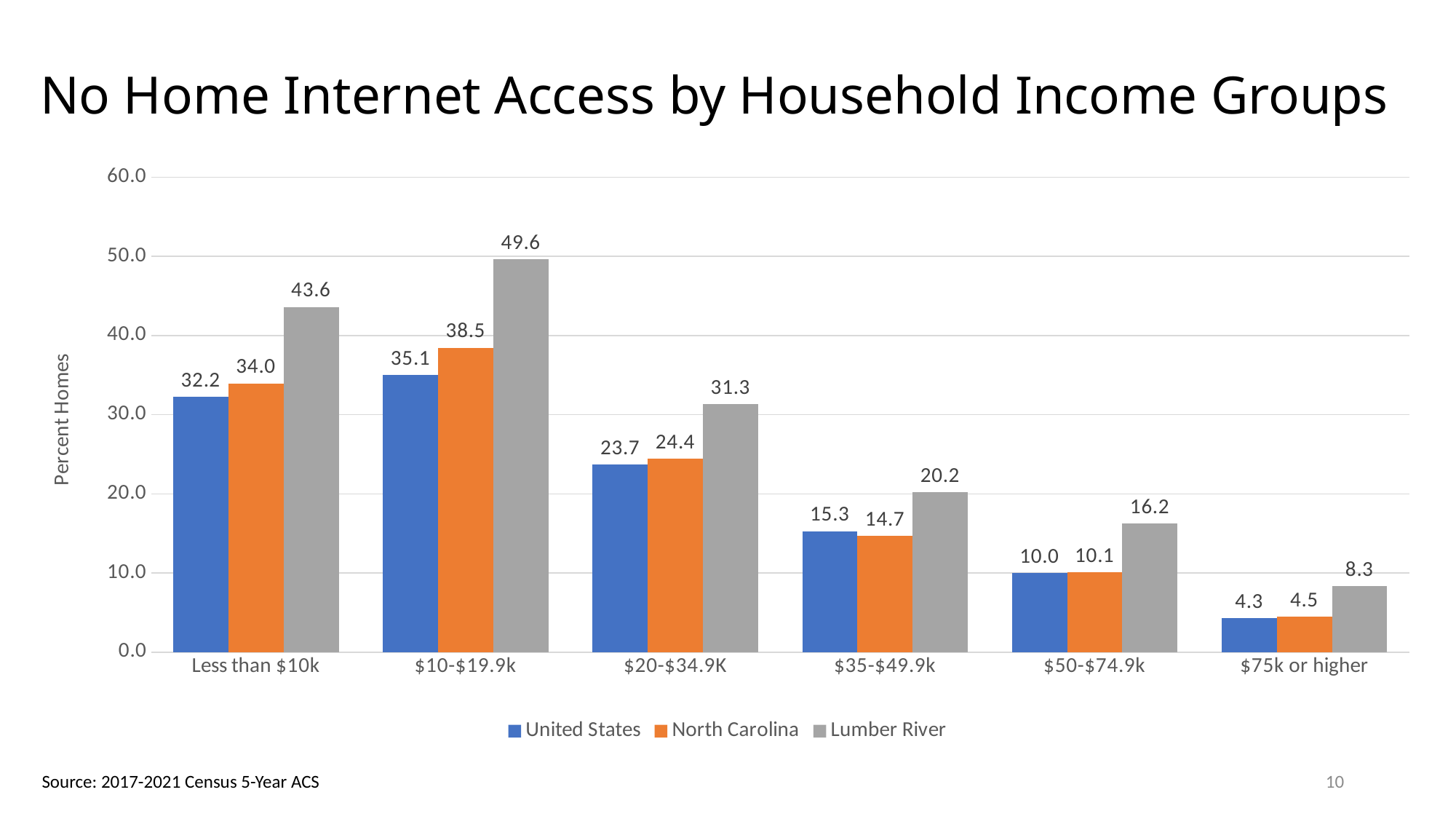
What is the value for North Carolina in the $35-$49.9k income group? 14.7 What is the value for United States in the Less than $10k income group? 32.2 What is the difference between the Lumber River and United States values in the $20-$34.9K income group? 7.6 What kind of chart is shown on the slide? bar chart Which is larger in the $35-$49.9k income group: the United States value or the North Carolina value? United States Is the value for Lumber River in the $50-$74.9k income group greater or less than 20.0? less What is the value for Lumber River in the $10-$19.9k income group? 49.6 What is the label of the y axis? Percent Homes How many income groups are shown on the x axis? 6 Which income group has the highest value for Lumber River? $10-$19.9k Which income group has the lowest value for United States? $75k or higher How many series does the legend list? 3